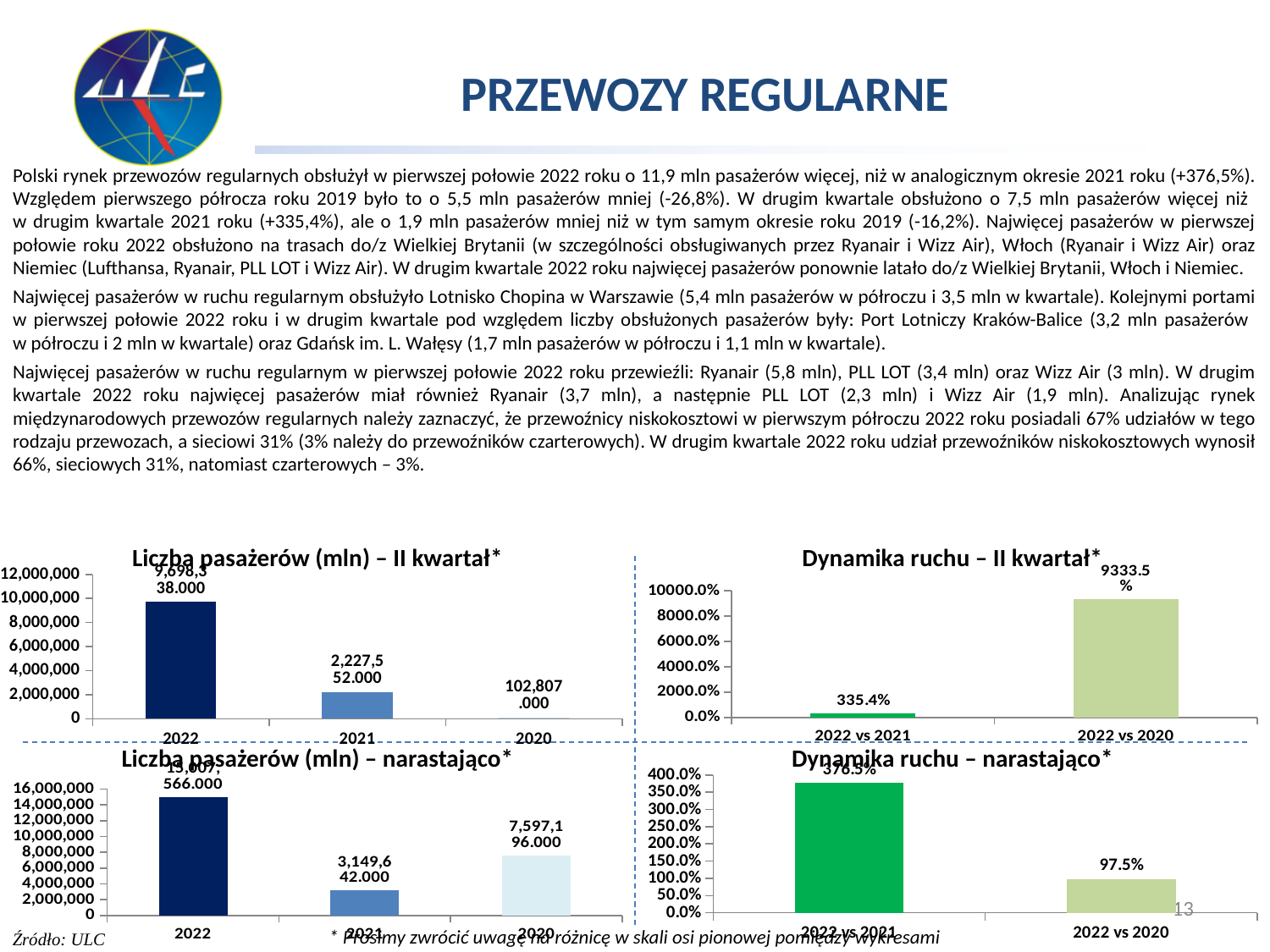
In the chart titled "Liczba pasażerów (mln) – narastająco*", is the value for 2022 greater or less than 14,000,000? greater In the chart titled "Liczba pasażerów (mln) – II kwartał*", what is the value for 2020? 102,807.000 In the chart titled "Liczba pasażerów (mln) – II kwartał*", which year has the highest value? 2022 In the chart titled "Liczba pasażerów (mln) – II kwartał*", what is the value for 2021? 2,227,552.000 In the chart titled "Dynamika ruchu – narastająco*", what is the difference between the 2022 vs 2021 value and the 2022 vs 2020 value? 279.0% In the chart titled "Liczba pasażerów (mln) – II kwartał*", which year has the lowest value? 2020 In the chart titled "Dynamika ruchu – narastająco*", what is the value for 2022 vs 2020? 97.5% In the chart titled "Liczba pasażerów (mln) – narastająco*", what is the value for 2021? 3,149,642.000 How many bars are in the chart titled "Liczba pasażerów (mln) – narastająco*"? 3 In the chart titled "Liczba pasażerów (mln) – narastająco*", what is the value for 2020? 7,597,196.000 In the chart titled "Dynamika ruchu – II kwartał*", what is the value for 2022 vs 2020? 9333.5% In the chart titled "Dynamika ruchu – II kwartał*", what is the value for 2022 vs 2021? 335.4%